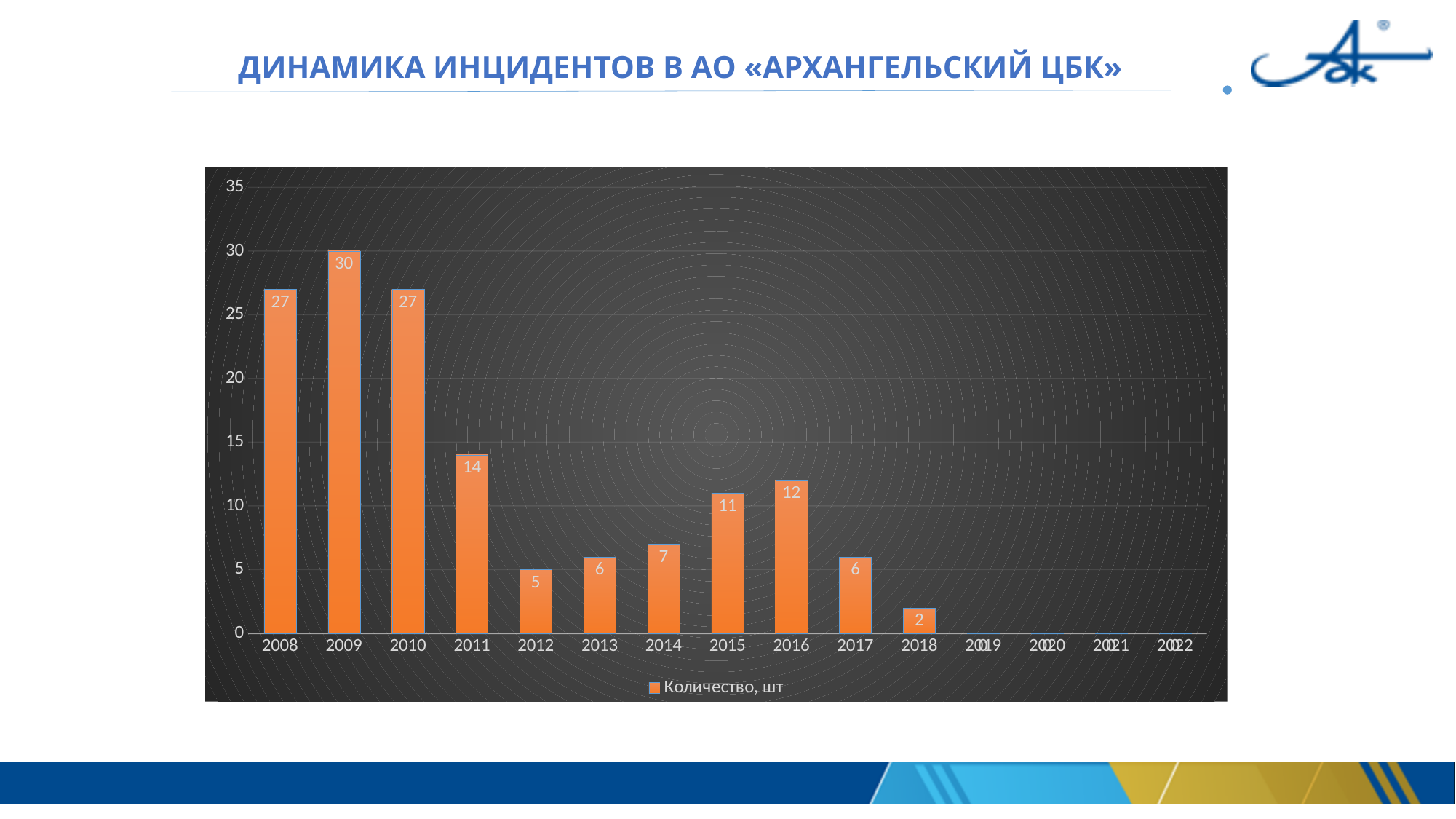
What is the value for 2011? 14 Which is larger, the value for 2014 or the value for 2013? 2014 How many series does the legend list? 1 What is the difference between the values for 2016 and 2017? 6 Which year has the highest value? 2009 What is the value for 2009? 30 What is the legend entry for the series? Количество, шт What type of chart is shown on the slide? Bar chart What is the value for 2018? 2 What is the difference between the values for 2009 and 2010? 3 How many years are shown on the x axis? 15 What is the value for 2015? 11